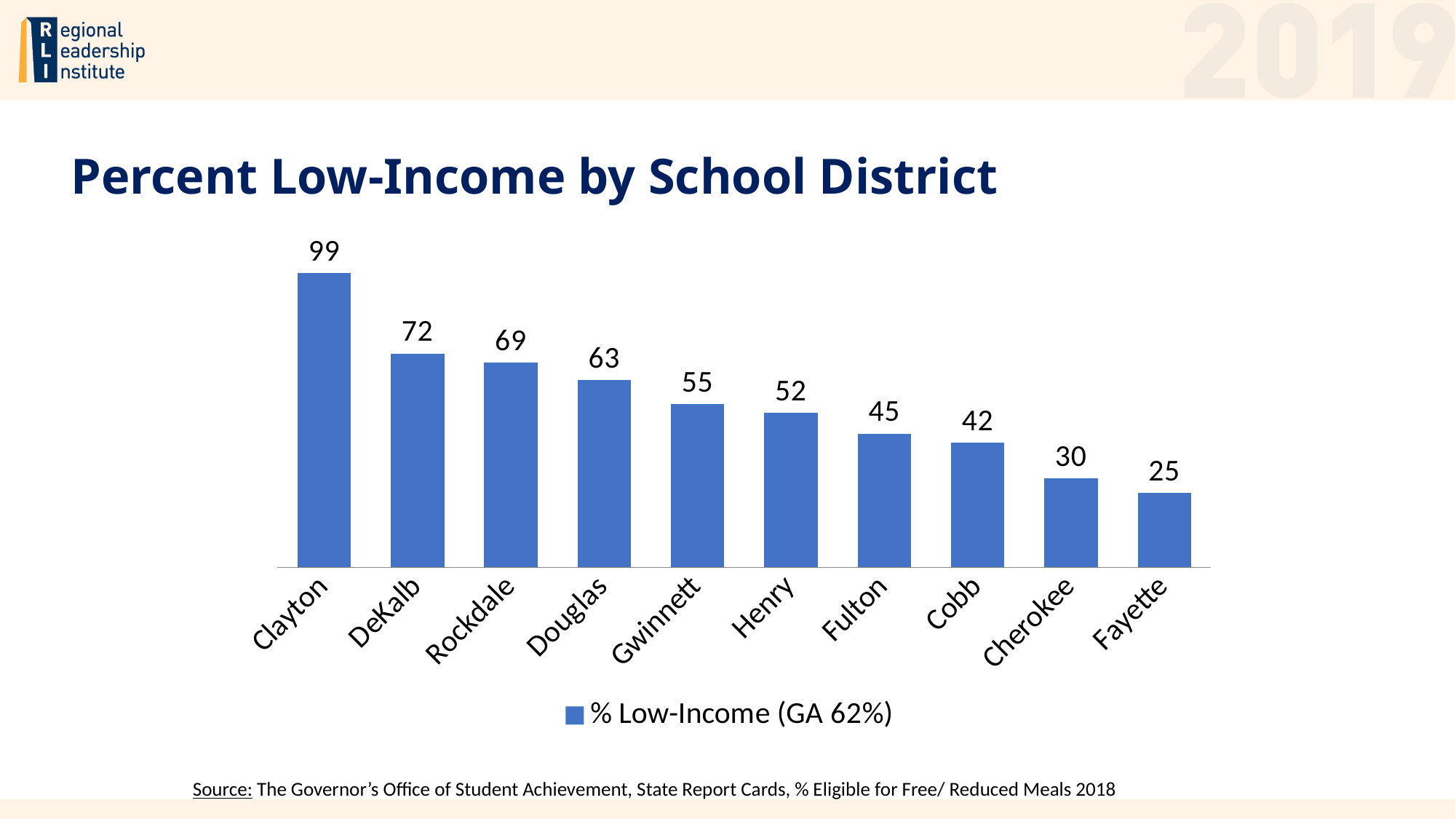
What is the difference between the values for DeKalb and Rockdale? 3 How many school districts are shown in the chart? 10 What is the percent low-income value for Clayton? 99 Which school district has the highest percent low-income? Clayton Which school district has the lowest percent low-income? Fayette What is the percent low-income value for Gwinnett? 55 What is the difference between the values for Clayton and Fayette? 74 What is the legend entry for the series in the chart? % Low-Income (GA 62%) How many series does the legend list? 1 What kind of chart is shown on the slide? Bar chart What is the percent low-income value for Cobb? 42 Which has a higher percent low-income, Henry or Fulton? Henry